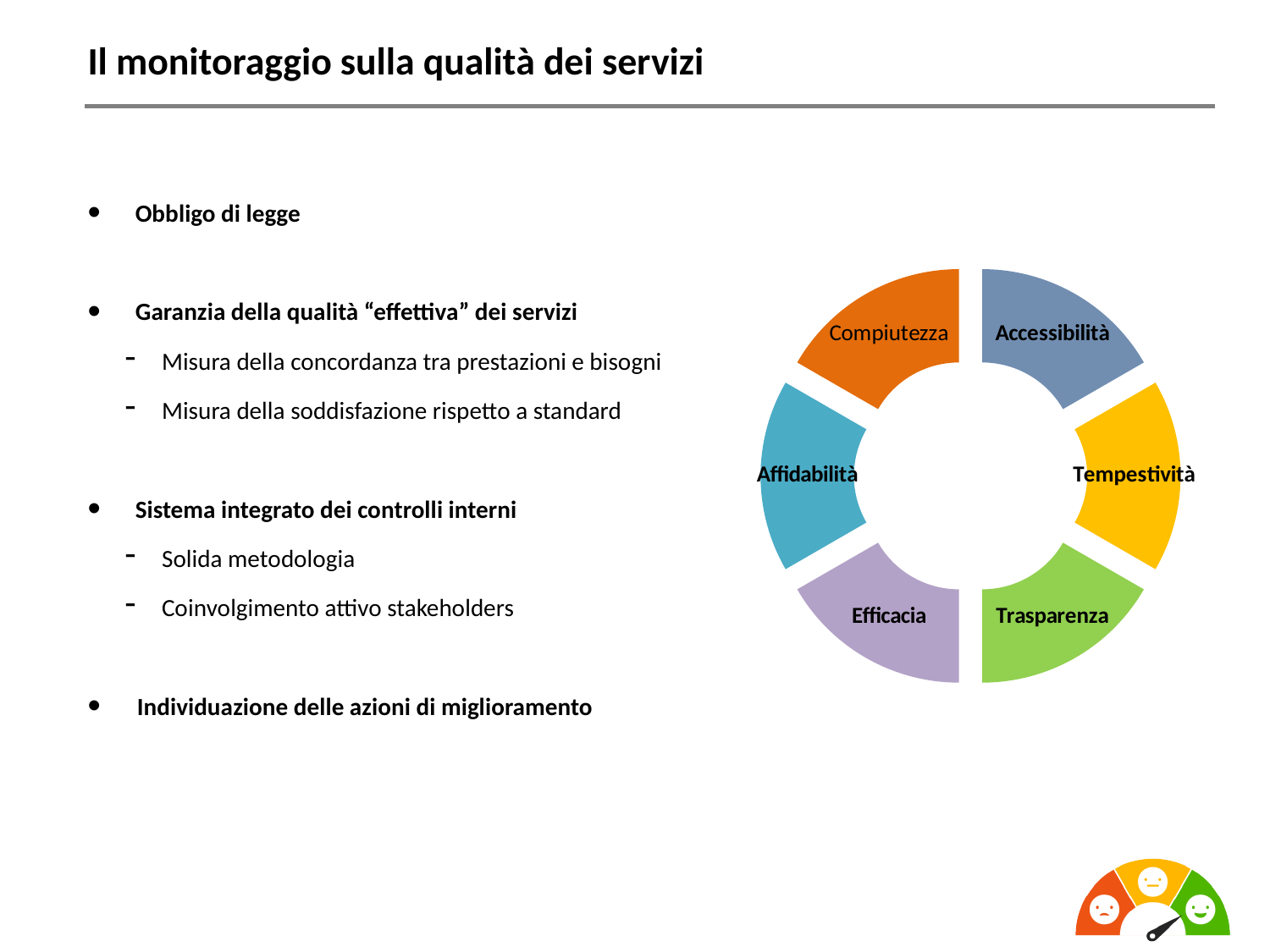
Which two segments are at the bottom of the donut chart? Efficacia and Trasparenza Do the six segments of the donut chart appear equal in size? Yes Which segment of the donut chart is coloured orange? Compiutezza Which segment of the donut chart sits directly to the right of Compiutezza at the top? Accessibilità How many segments does the donut chart have? 6 Which segment of the donut chart is positioned at the far left, opposite Tempestività? Affidabilità What kind of chart is shown on the right side of the slide? Donut chart What colour is the Tempestività segment of the donut chart? Yellow